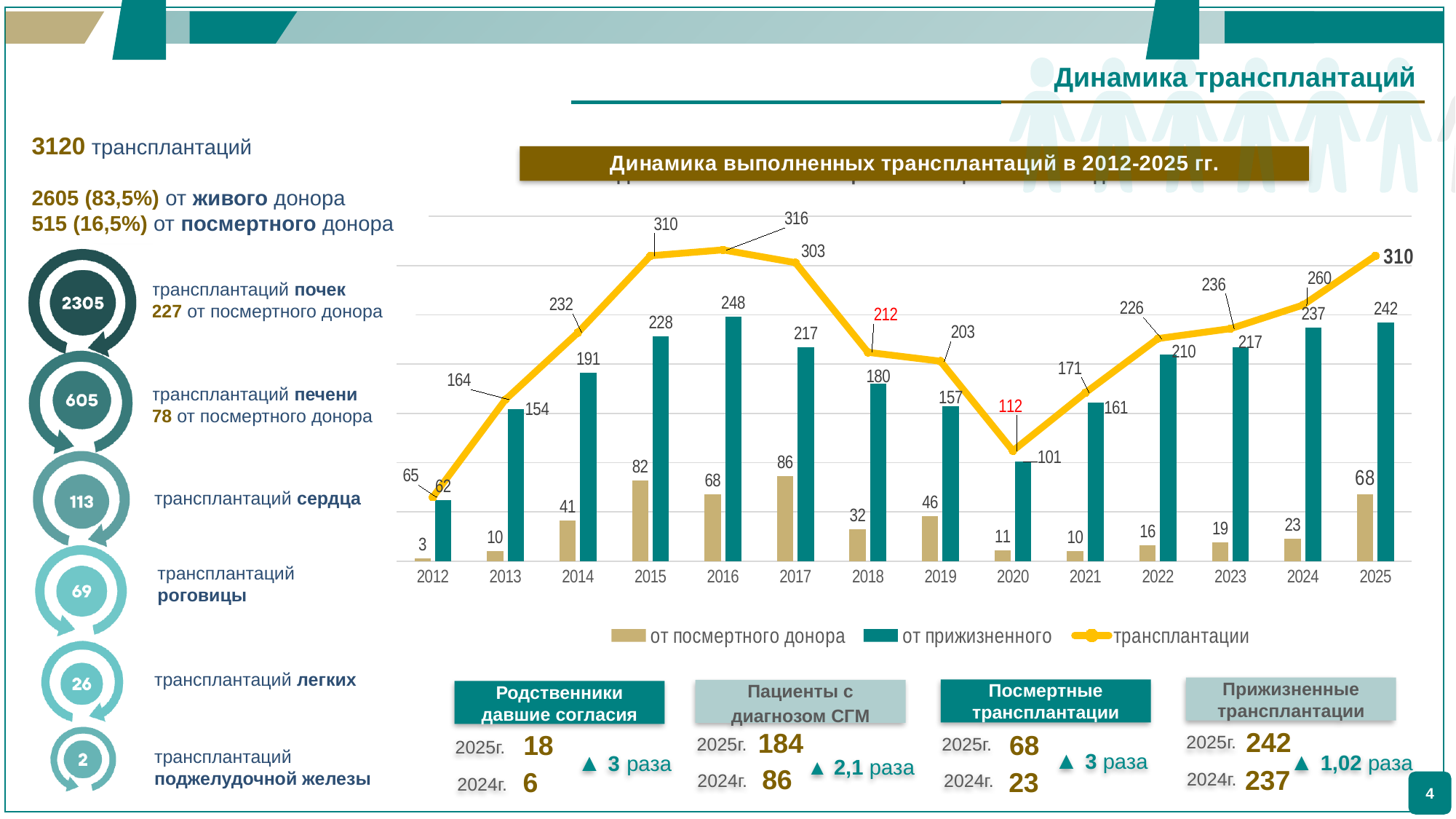
Which is larger: the 'от прижизненного' bar for 2016 or for 2017? 2016 What is the value of the 'от прижизненного' bar for 2025? 242 Does the 'трансплантации' line rise or fall from 2020 to 2025? Rise What is the value of the 'от посмертного донора' bar for 2017? 86 In which year does the 'трансплантации' line reach its highest value? 2016 What is the value of the 'трансплантации' line for 2016? 316 What kind of chart is shown on the slide? Combined bar and line chart What is the difference between the 'трансплантации' values for 2025 and 2024? 50 In which year is the 'от прижизненного' bar lowest? 2012 How many years are shown on the x axis of the chart? 14 In which year is the 'от посмертного донора' bar lowest? 2012 How many series does the chart legend list? 3